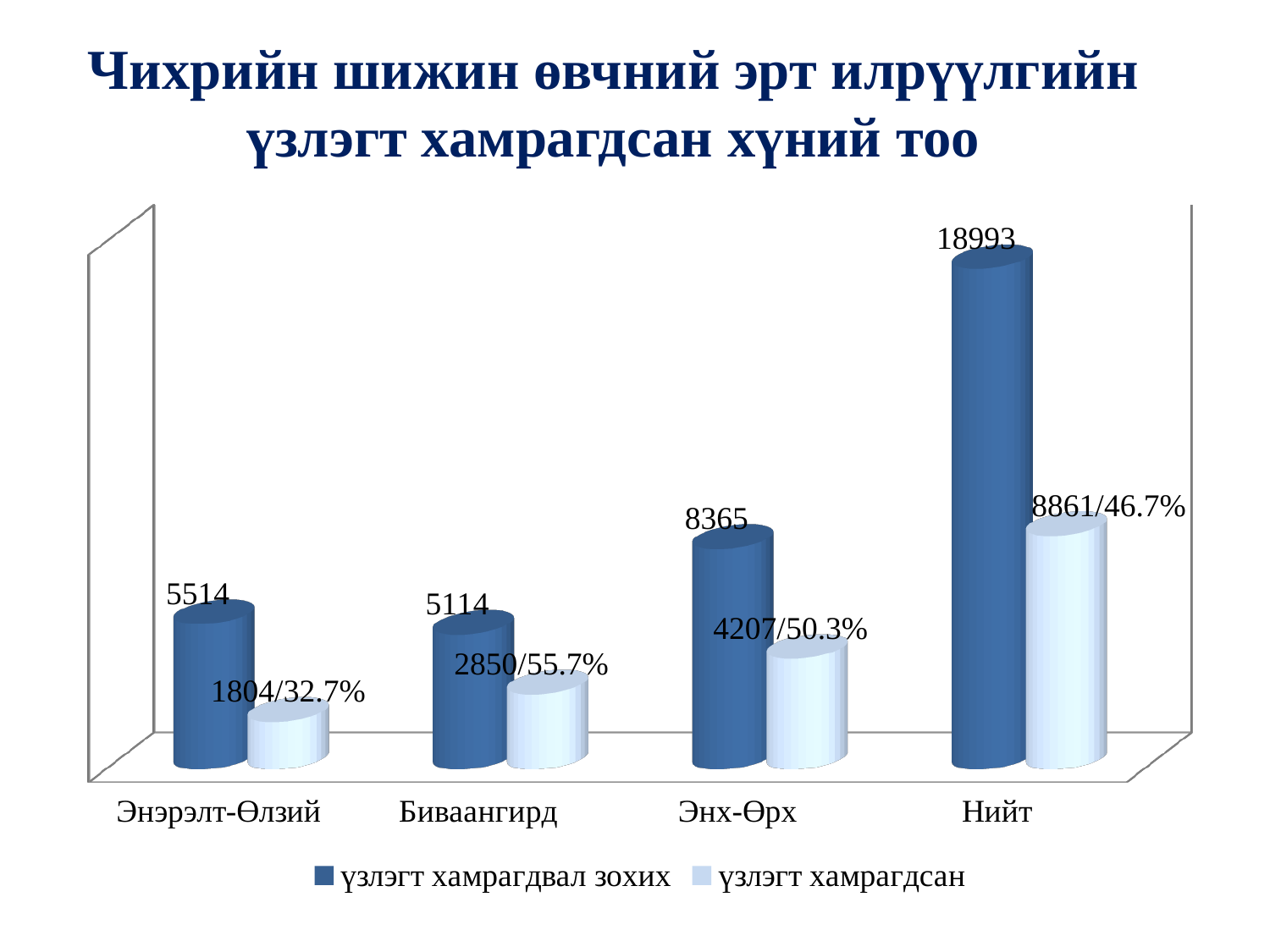
What kind of chart is shown on the slide? Bar chart What data label is shown for Биваангирд in the series үзлэгт хамрагдсан? 2850/55.7% What is the difference between the үзлэгт хамрагдвал зохих value and the үзлэгт хамрагдсан count for Нийт? 10132 What data label is shown for Нийт in the series үзлэгт хамрагдсан? 8861/46.7% Which is larger for the series үзлэгт хамрагдвал зохих: Энэрэлт-Өлзий or Биваангирд? Энэрэлт-Өлзий Which category has the lowest value in the series үзлэгт хамрагдсан? Энэрэлт-Өлзий How many categories are shown on the x axis? 4 Which series is shown in dark blue according to the legend? үзлэгт хамрагдвал зохих Which category has the highest value in the series үзлэгт хамрагдвал зохих? Нийт How many series does the legend list? 2 What is the value for Энх-Өрх in the series үзлэгт хамрагдвал зохих? 8365 What is the value for Энэрэлт-Өлзий in the series үзлэгт хамрагдвал зохих? 5514